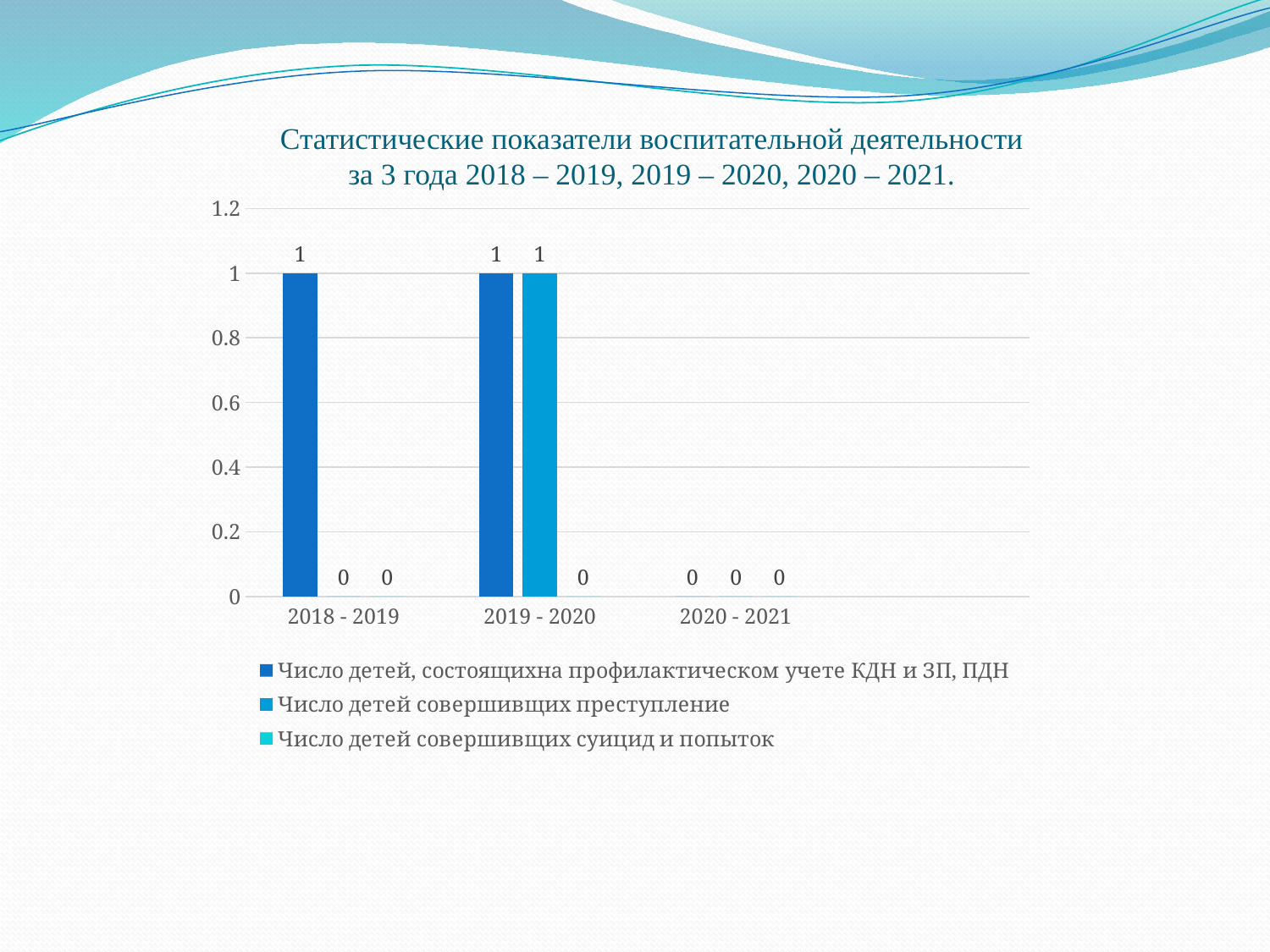
What is the value for "Число детей, состоящихна профилактическом учете КДН и ЗП, ПДН" in 2018 - 2019? 1 How many categories (school years) are shown on the x axis? 3 What is the value for "Число детей, состоящихна профилактическом учете КДН и ЗП, ПДН" in 2020 - 2021? 0 What is the value for "Число детей совершивших суицид и попыток" in 2019 - 2020? 0 What is the value for "Число детей совершивших преступление" in 2019 - 2020? 1 How many series does the legend list? 3 Which is larger: the value for "Число детей совершивших преступление" in 2019 - 2020 or in 2020 - 2021? 2019 - 2020 What is the value for "Число детей совершивших преступление" in 2018 - 2019? 0 What kind of chart is shown on the slide? bar chart What is the title of the chart? Статистические показатели воспитательной деятельности за 3 года 2018 – 2019, 2019 – 2020, 2020 – 2021. What is the difference between the value for "Число детей совершивших преступление" in 2019 - 2020 and in 2018 - 2019? 1 Does the value for "Число детей, состоящихна профилактическом учете КДН и ЗП, ПДН" rise or fall from 2019 - 2020 to 2020 - 2021? fall